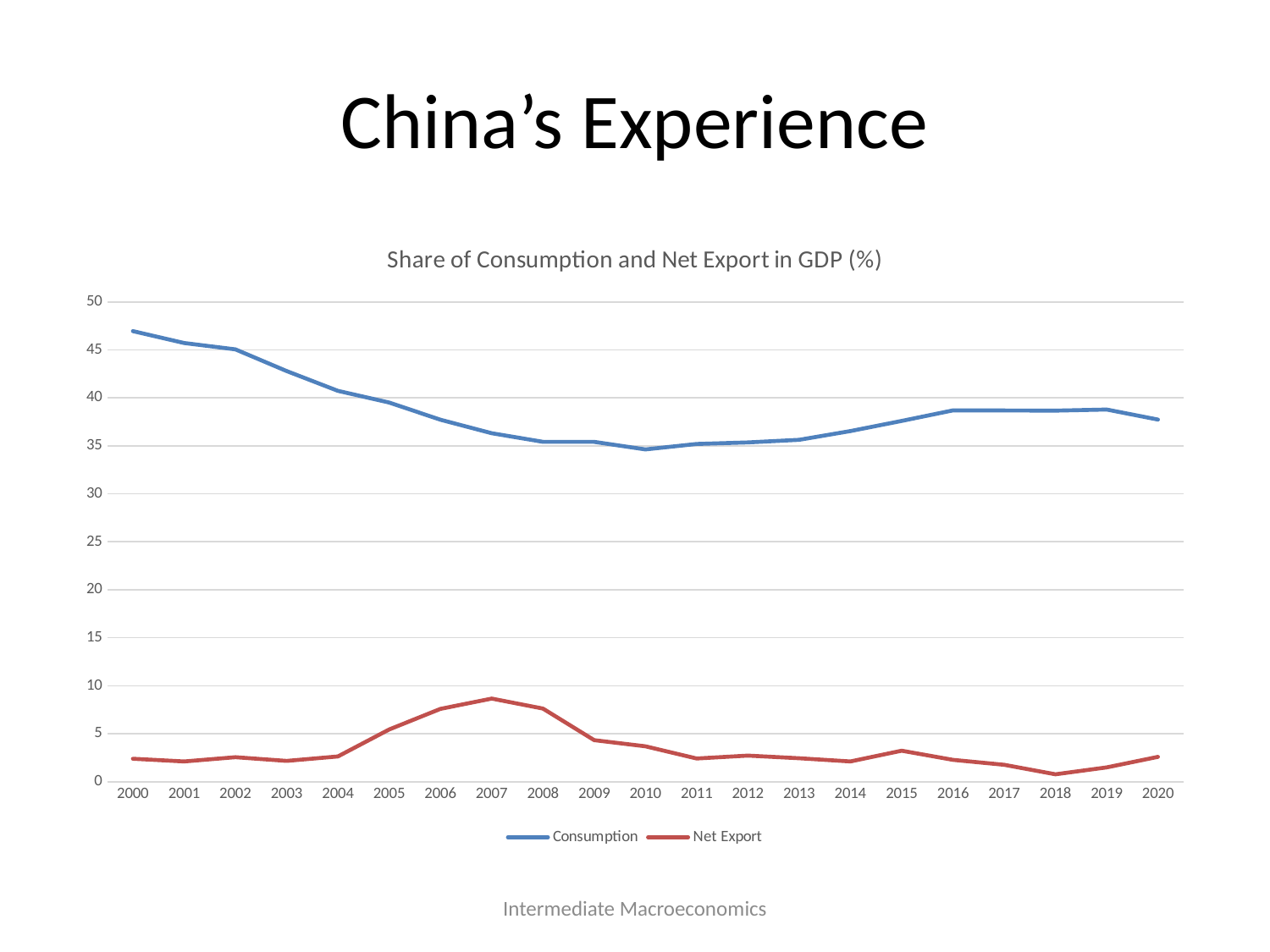
How many series does the legend list? 2 In which year is the Net Export series at its lowest? 2018 Is the Net Export value for 2018 greater or less than 5? less What kind of chart is shown on the slide? line chart How many years are plotted along the x axis? 21 Is the Consumption value for 2000 greater or less than 45? greater Is the Net Export value for 2007 greater or less than 5? greater In which year is the Consumption series at its highest? 2000 Does the Consumption series rise or fall from 2000 to 2010? fall In which year is the Net Export series at its highest? 2007 Which is larger, the Consumption value in 2000 or in 2020? 2000